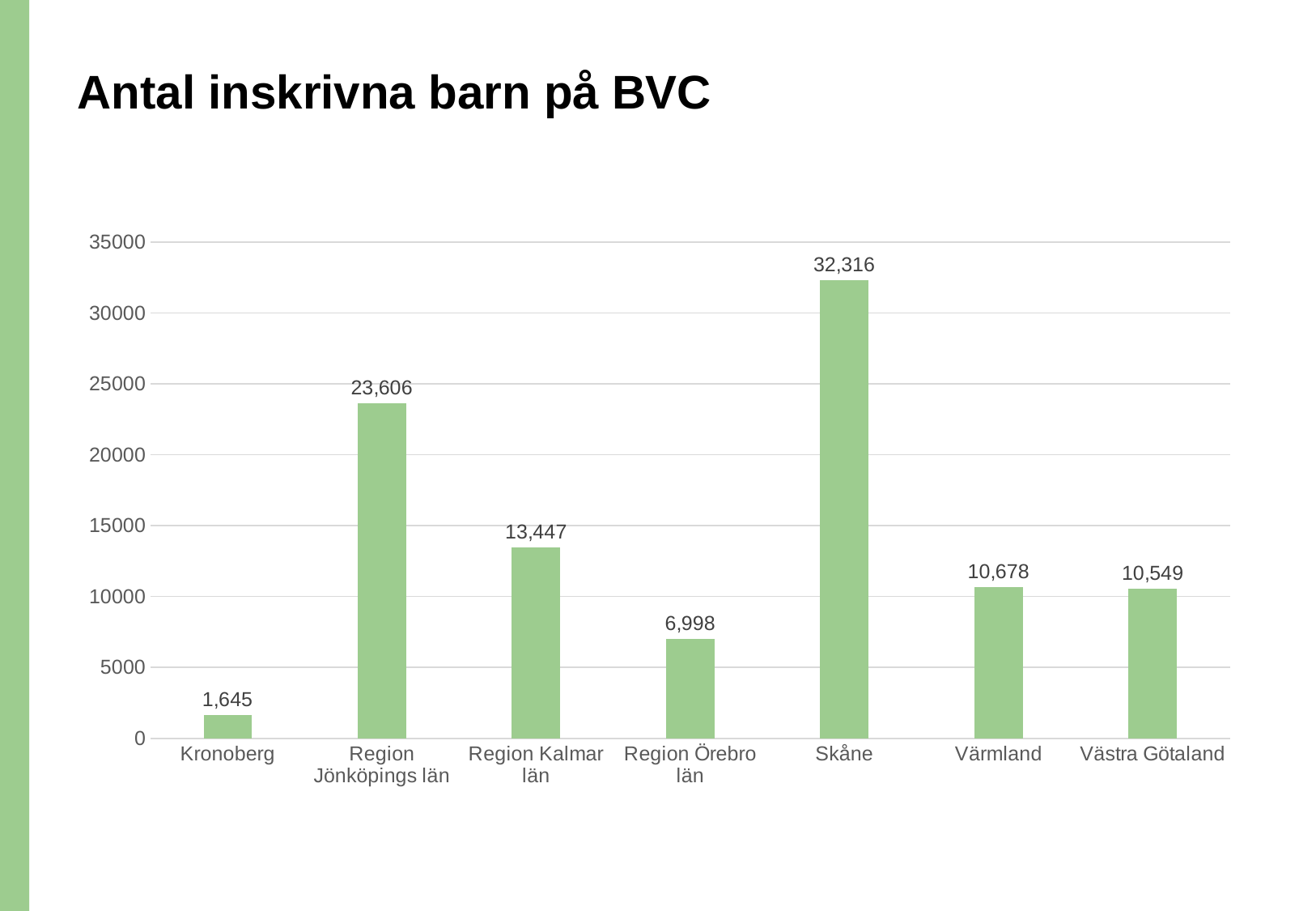
Which category has the highest value? Skåne What is the difference between the values for Värmland and Västra Götaland? 129 What kind of chart is shown on the slide? bar chart Which is larger, the value for Region Kalmar län or the value for Region Örebro län? Region Kalmar län How many categories are shown on the x axis? 7 What is the value for Skåne? 32,316 What is the title of the slide? Antal inskrivna barn på BVC Which category has the lowest value? Kronoberg Is the value for Region Jönköpings län greater or less than 20000? greater What is the difference between the values for Skåne and Region Jönköpings län? 8,710 What is the value for Kronoberg? 1,645 What is the value for Region Örebro län? 6,998